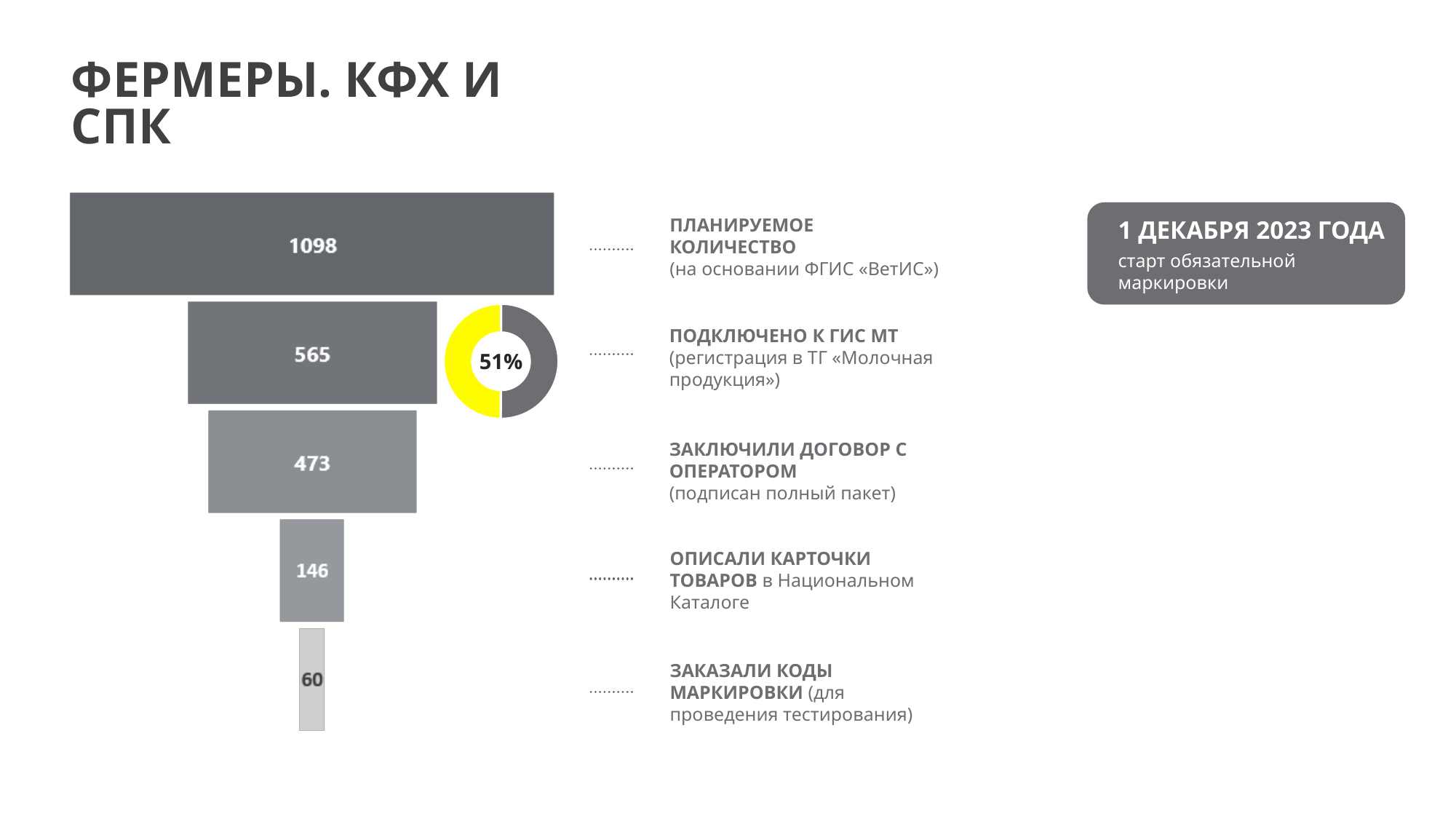
In the funnel chart, which stage has the lowest value? Заказали коды маркировки What percentage does the small donut chart next to the «Подключено к ГИС МТ» stage show? 51% In the funnel chart, which stage has the highest value? Планируемое количество In the funnel chart, what is the difference between «Заключили договор с оператором» and «Описали карточки товаров»? 327 In the funnel chart, what is the value for «Планируемое количество»? 1098 How many stages does the funnel chart show? 5 In the funnel chart, what is the value for «Подключено к ГИС МТ»? 565 In the funnel chart, what is the value for «Заказали коды маркировки»? 60 In the funnel chart, what is the difference between «Планируемое количество» and «Подключено к ГИС МТ»? 533 In the funnel chart, what is the value for «Описали карточки товаров»? 146 In the funnel chart, what is the value for «Заключили договор с оператором»? 473 What kind of chart is the main chart on the left of the slide? Funnel chart